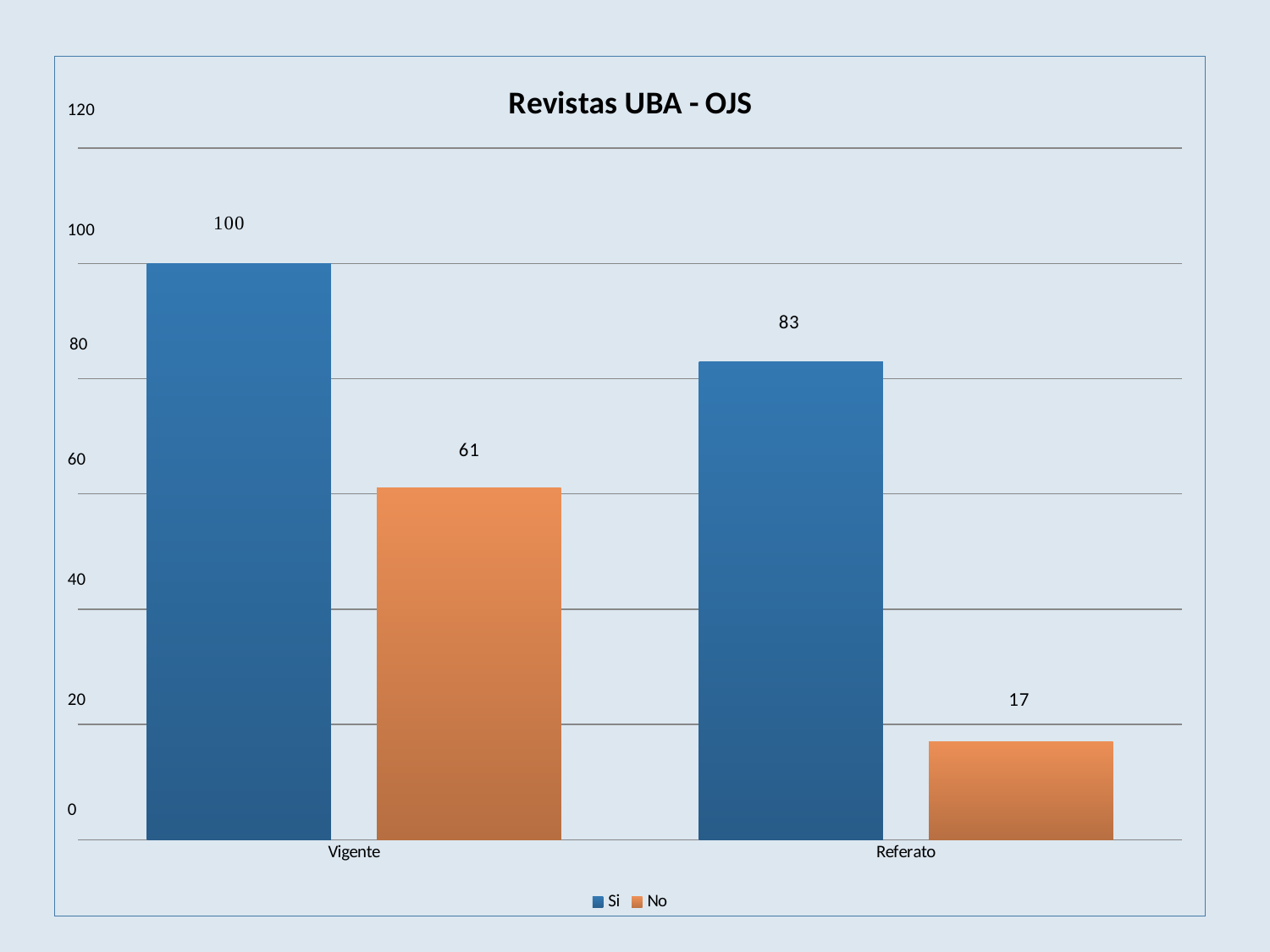
What type of chart is shown on the slide? Bar chart What is the difference between the Si and No values in the Referato category? 66 How many categories are shown on the x axis? 2 How many series does the legend list? 2 What is the value for Si in the Vigente category? 100 What is the difference between the Si values for Vigente and Referato? 17 Which category has the highest value for the Si series? Vigente What is the value for No in the Vigente category? 61 Which is larger: the No value for Vigente or the Si value for Referato? Si value for Referato Which category has the lowest value for the No series? Referato What is the value for No in the Referato category? 17 What is the value for Si in the Referato category? 83